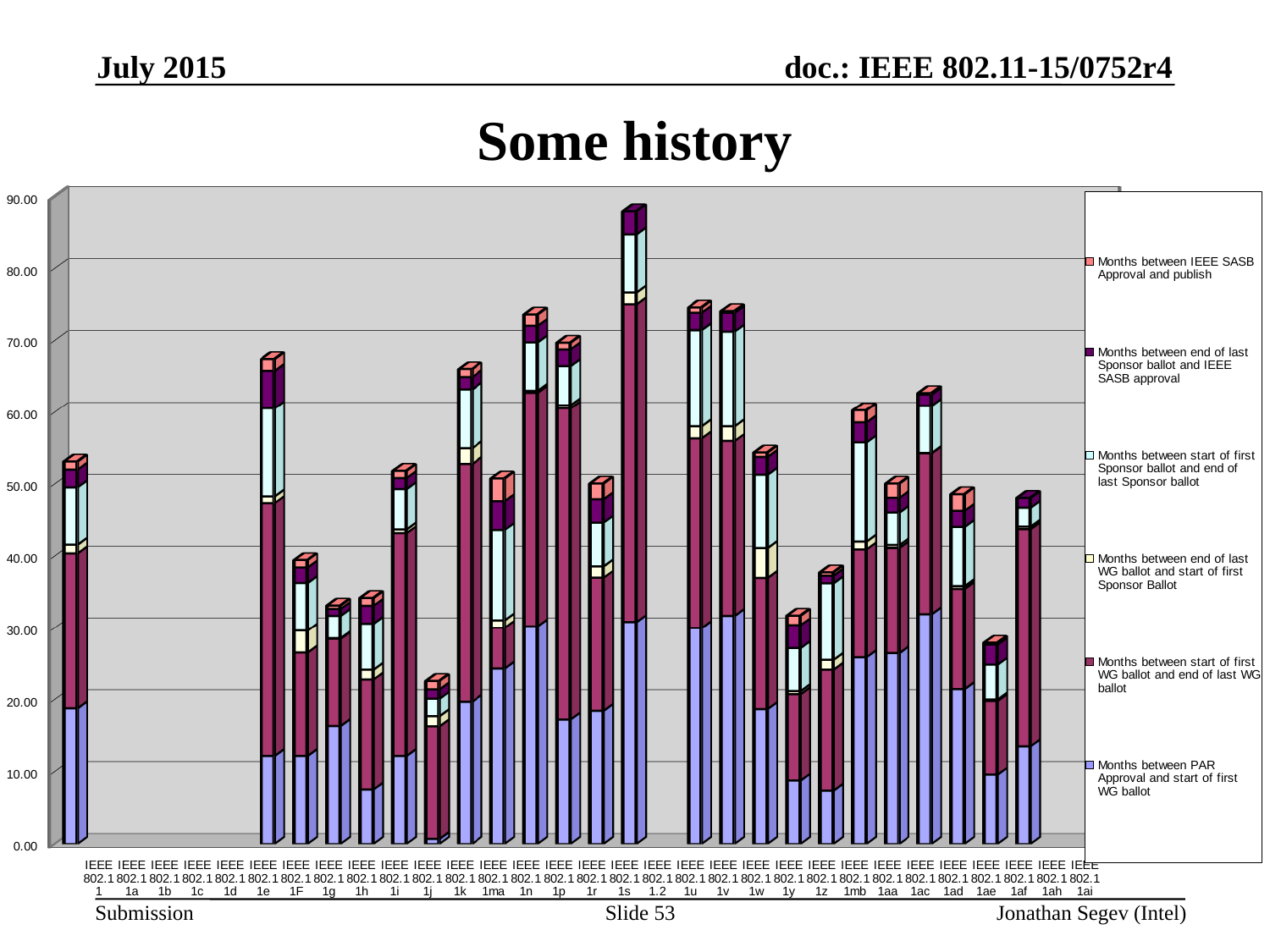
Which category has the tallest stacked bar? IEEE 802.11s Is the total for IEEE 802.11ae greater or less than 30? less What kind of chart is shown on the slide? Stacked bar chart Is the total for IEEE 802.11e greater or less than 60? greater Is the total for IEEE 802.11j greater or less than 30? less How many series does the legend list? 6 Which has the taller stacked bar, IEEE 802.11s or IEEE 802.11e? IEEE 802.11s Which series is shown at the bottom of each stacked bar, according to the legend? Months between PAR Approval and start of first WG ballot Which has the taller stacked bar, IEEE 802.11j or IEEE 802.11k? IEEE 802.11k